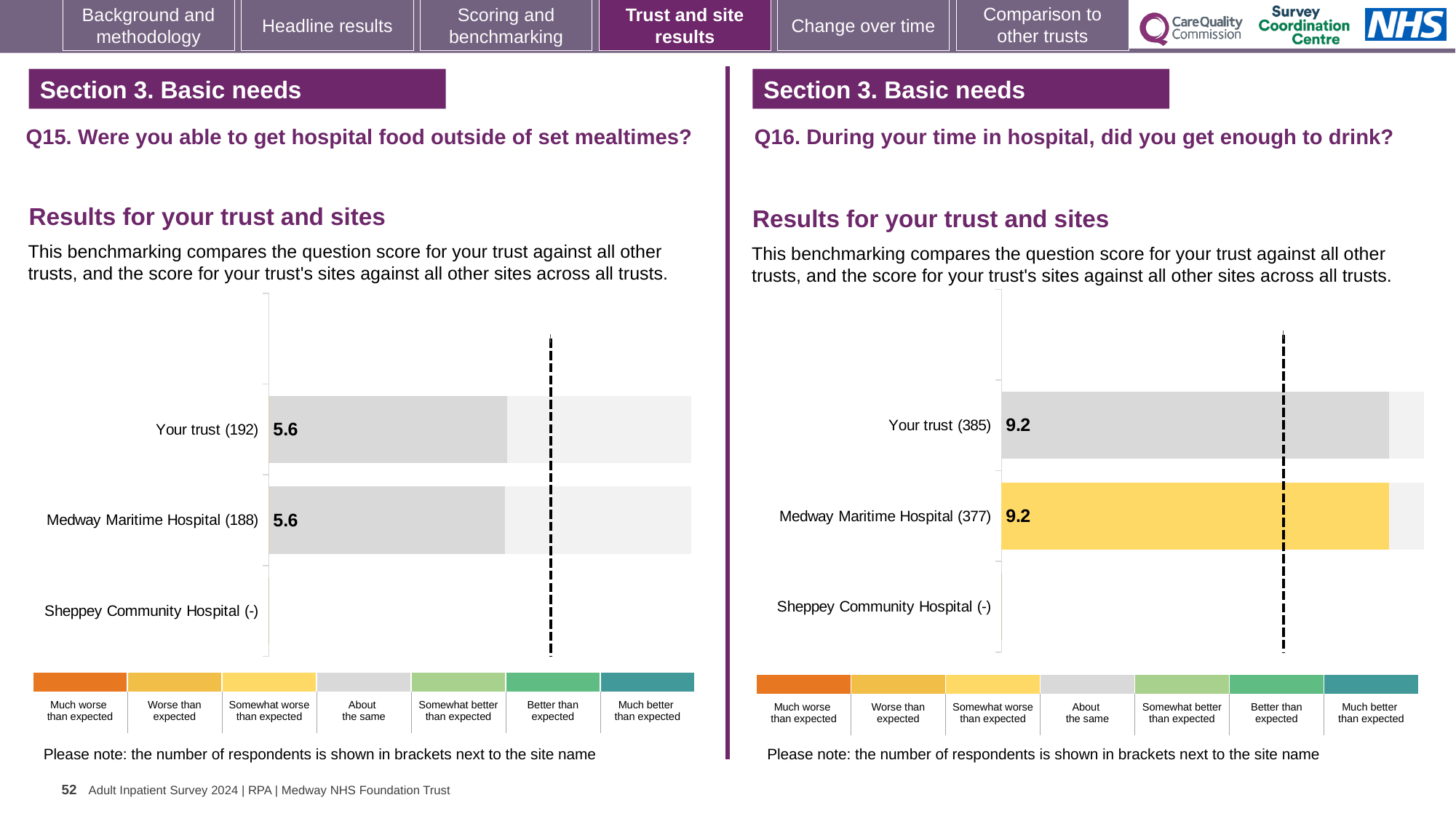
In the Q15 chart, what is the score for Your trust? 5.6 In the Q15 chart, how many respondents are shown in brackets for Your trust? 192 In the Q16 chart, how many categories (rows) are listed on the vertical axis? 3 In the Q16 chart, what is the score for Medway Maritime Hospital? 9.2 In the Q15 chart, what is the score for Medway Maritime Hospital? 5.6 What kind of chart is used for the Q15 results? Bar chart In the Q15 chart, what is the difference between the score for Your trust and the score for Medway Maritime Hospital? 0 In the Q16 chart, which site has no score shown? Sheppey Community Hospital In the Q16 chart, what is the score for Your trust? 9.2 In the Q16 chart, how many respondents are shown in brackets for Medway Maritime Hospital? 377 In the Q16 chart, which benchmark category does the colour of the Medway Maritime Hospital bar correspond to? Somewhat worse than expected